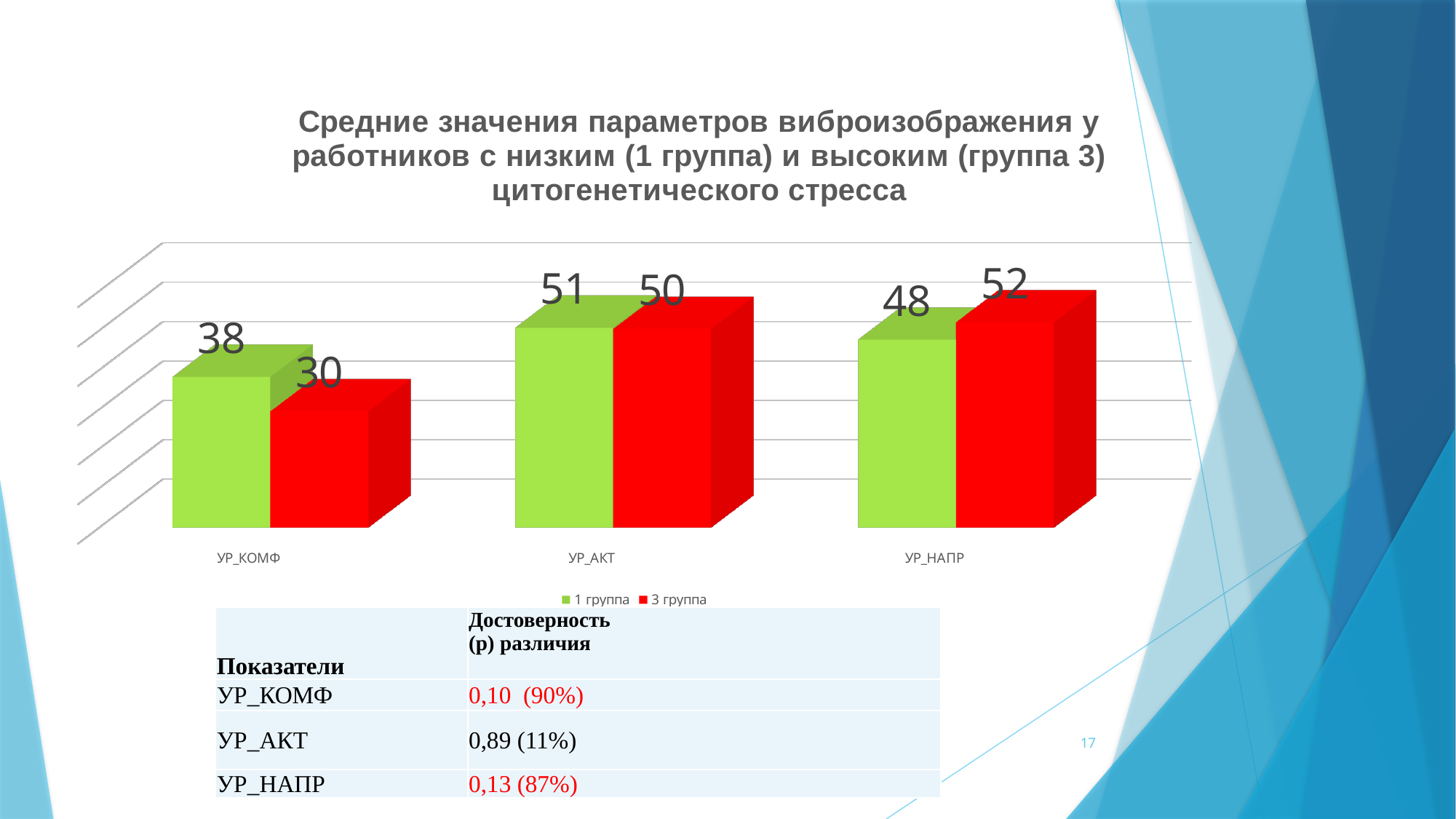
Which category has the highest value for 1 группа? УР_АКТ In the УР_НАПР category, which series has the larger value, 1 группа or 3 группа? 3 группа What is the difference between the 1 группа and 3 группа values in the УР_КОМФ category? 8 What is the value for 1 группа in the УР_КОМФ category? 38 How many series does the chart legend list? 2 What is the value for 3 группа in the УР_НАПР category? 52 How many categories are shown on the x axis of the chart? 3 What is the value for 1 группа in the УР_АКТ category? 51 Which colour represents 3 группа in the chart? Red What is the value for 3 группа in the УР_КОМФ category? 30 What kind of chart is shown on the slide? Bar chart Which category has the lowest value for 3 группа? УР_КОМФ